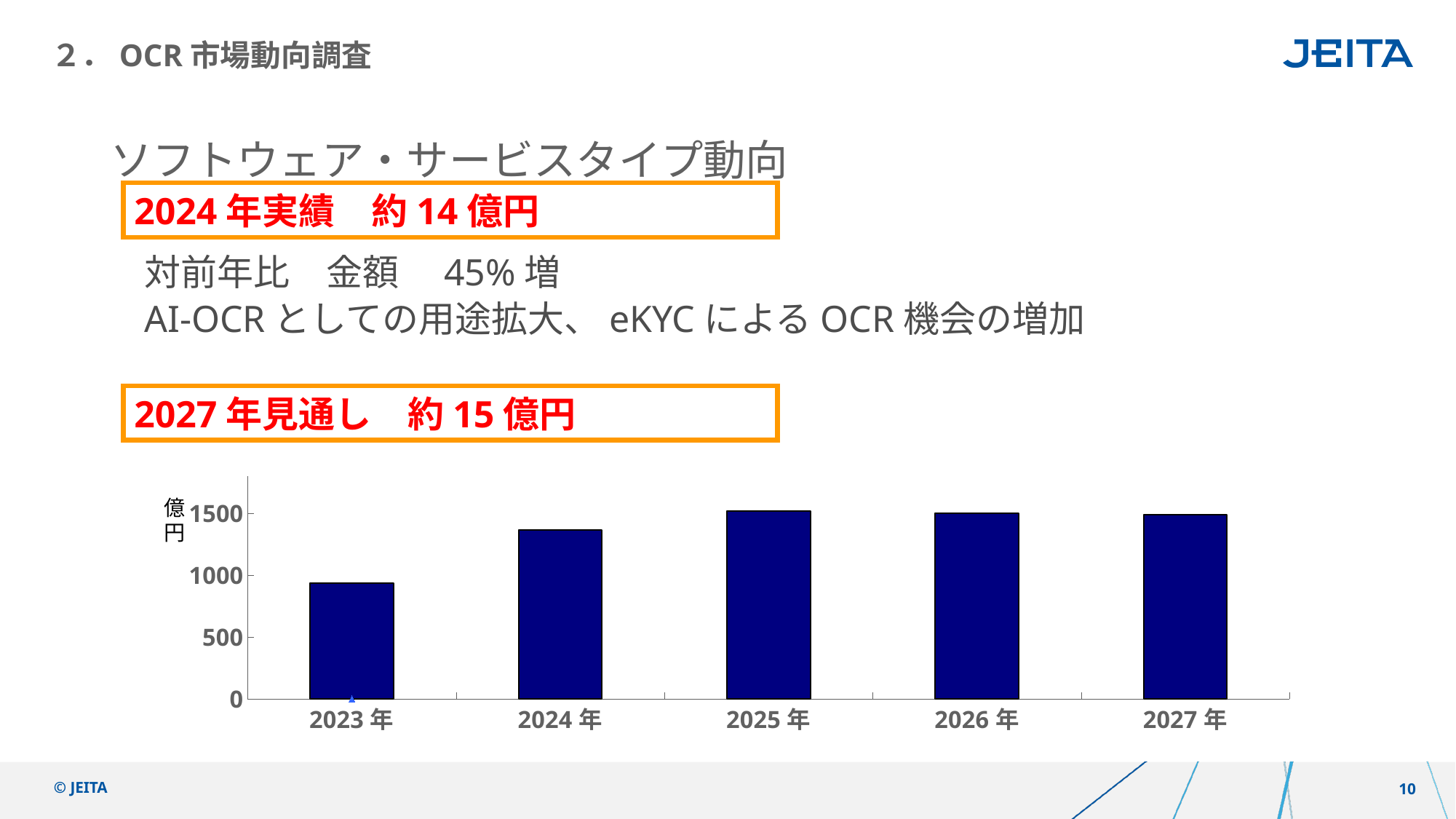
Which year has the lowest bar in the chart? 2023年 Which is larger, the value for 2023年 or the value for 2024年? 2024年 Is the value for 2023年 greater or less than 1000? less How many bars (years) are plotted in the chart? 5 What kind of chart is shown on the slide? bar chart Do the values rise or fall from 2023年 to 2024年? rise What is the first year shown on the x axis of the chart? 2023年 Is the value for 2024年 greater or less than 1500? less What unit label is shown on the y axis of the chart? 億円 Which is larger, the value for 2023年 or the value for 2025年? 2025年 Is the value for 2024年 greater or less than 1000? greater